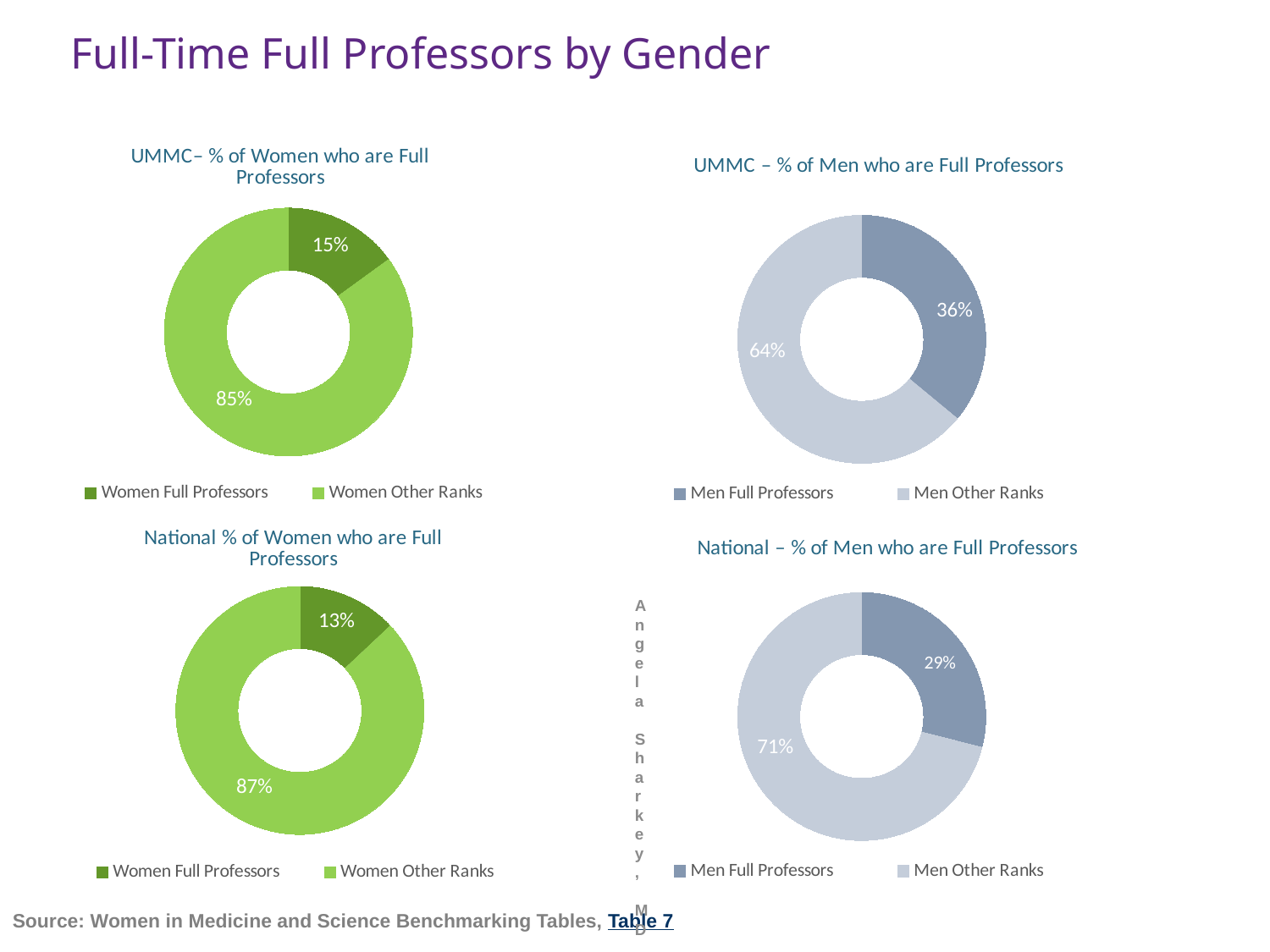
In the 'National – % of Men who are Full Professors' chart, what percentage is shown for Men Other Ranks? 71% What type of chart is the 'UMMC – % of Men who are Full Professors' chart? Doughnut chart How many entries does the legend of the 'National % of Women who are Full Professors' chart list? 2 In the 'National – % of Men who are Full Professors' chart, which slice is the largest? Men Other Ranks In the 'UMMC – % of Men who are Full Professors' chart, what percentage is shown for Men Other Ranks? 64% Which is larger: the Women Full Professors share in the 'UMMC– % of Women who are Full Professors' chart or in the 'National % of Women who are Full Professors' chart? UMMC– % of Women who are Full Professors In the 'National % of Women who are Full Professors' chart, what percentage is shown for Women Full Professors? 13% In the 'UMMC– % of Women who are Full Professors' chart, which slice is the smallest? Women Full Professors In the 'UMMC– % of Women who are Full Professors' chart, what percentage is shown for Women Other Ranks? 85% What is the difference between the Men Full Professors percentage in the 'UMMC – % of Men who are Full Professors' chart and the 'National – % of Men who are Full Professors' chart? 7% In the 'UMMC – % of Men who are Full Professors' chart, what percentage is shown for Men Full Professors? 36% In the 'UMMC– % of Women who are Full Professors' chart, what percentage is shown for Women Full Professors? 15%